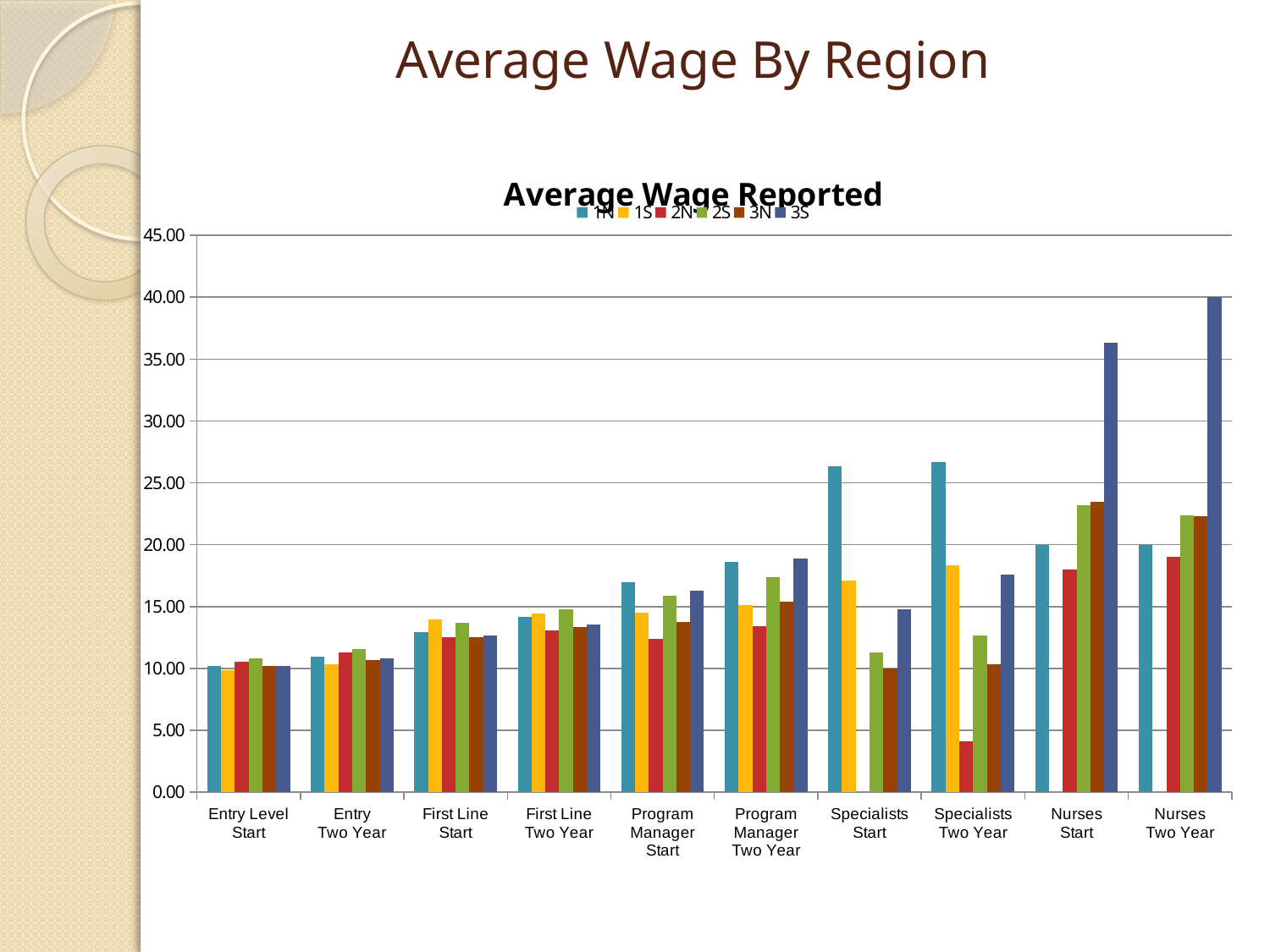
Is the value for 1N in the Specialists Start group greater or less than 25.00? greater What is the value for 1N in the Nurses Start group? 20.00 Which category has the tallest bar in the chart? Nurses Two Year What kind of chart is shown on the slide? bar chart What is the title of the chart? Average Wage Reported What is the value for 3S in the Nurses Two Year group? 40.00 Which series has the tallest bar in the whole chart? 3S Is the value for 2N in the Specialists Two Year group greater or less than 5.00? less How many job categories are shown along the x axis? 10 Which series has the shortest bar in the Specialists Two Year group? 2N In the Specialists Start group, which is larger, the 1N bar or the 3S bar? 1N How many series does the legend list? 6